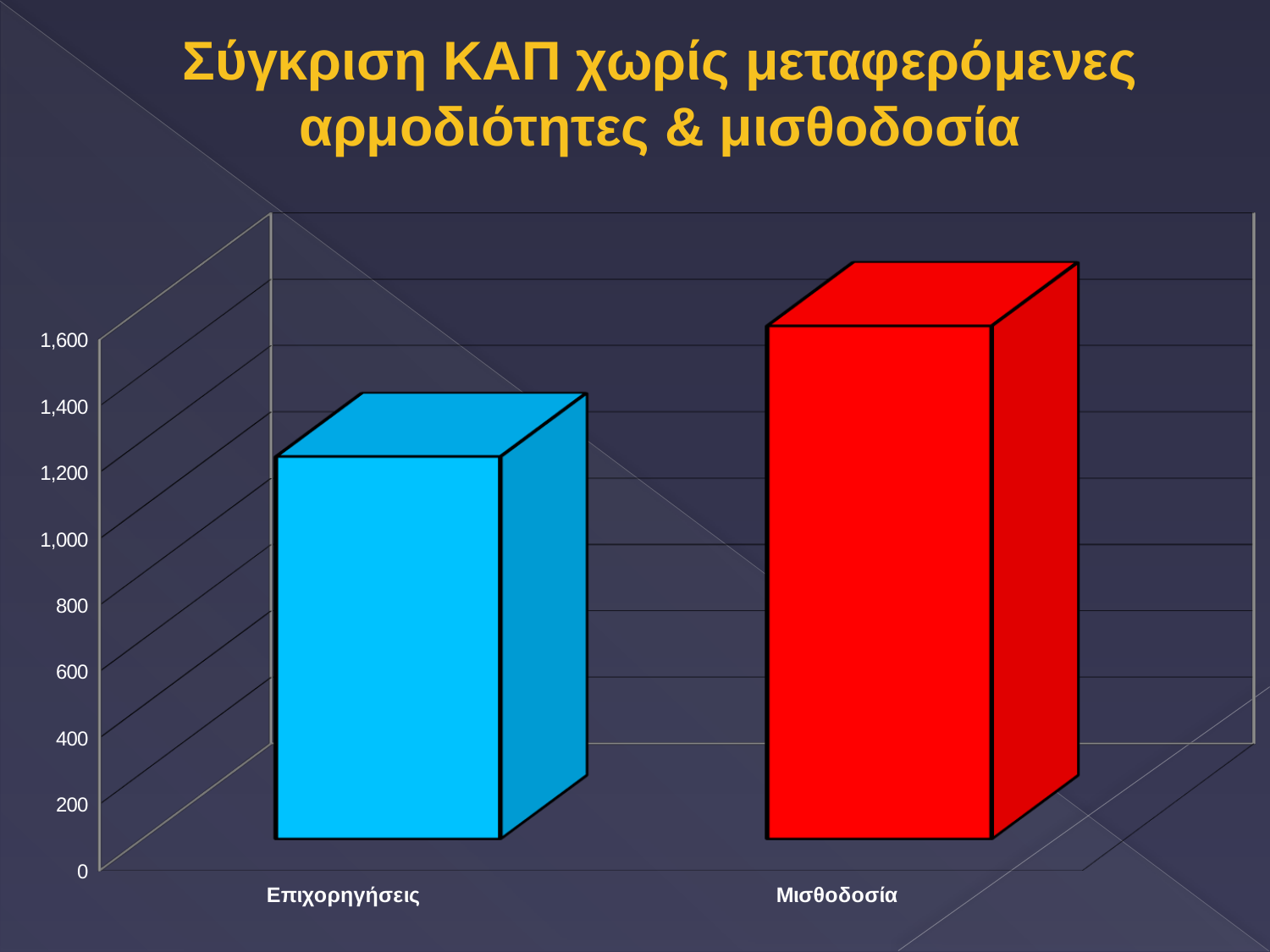
Which category has the highest value? Μισθοδοσία What colour is the bar for Μισθοδοσία? red What is the title of the chart on the slide? Σύγκριση ΚΑΠ χωρίς μεταφερόμενες αρμοδιότητες & μισθοδοσία Is the value for Μισθοδοσία greater or less than 1,400? greater Is the value for Επιχορηγήσεις greater or less than 1,400? less Is the value for Μισθοδοσία greater or less than 1,200? greater Which category has the lowest value? Επιχορηγήσεις Which is larger, the value for Επιχορηγήσεις or the value for Μισθοδοσία? Μισθοδοσία What kind of chart is shown on the slide? bar chart How many categories are plotted on the chart? 2